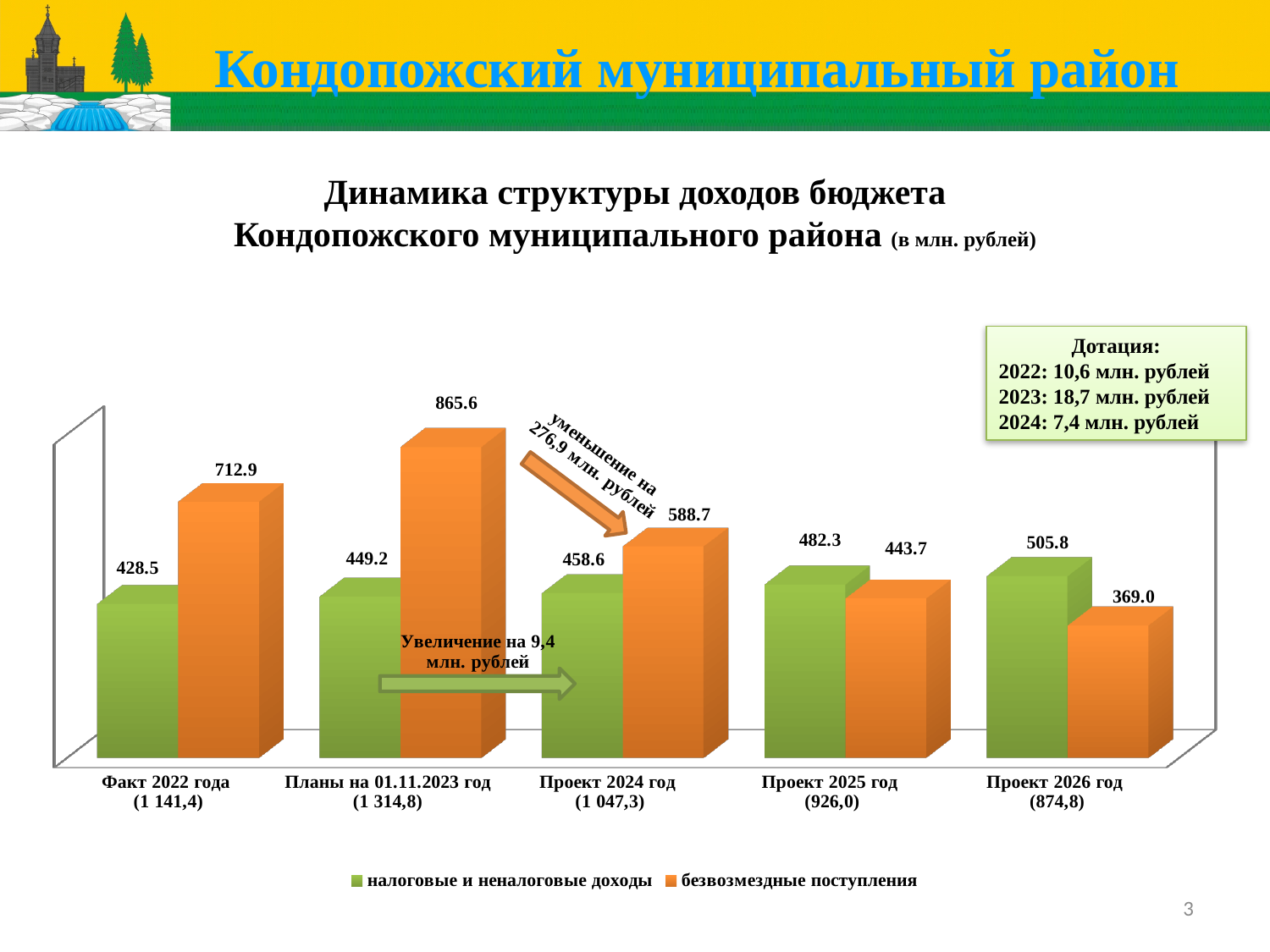
How many categories are shown on the x axis? 5 What is the value of безвозмездные поступления for Проект 2026 год? 369.0 Which category has the highest value for безвозмездные поступления? Планы на 01.11.2023 год What is the value of безвозмездные поступления for Планы на 01.11.2023 год? 865.6 What kind of chart is shown on the slide? bar chart How many series does the legend list? 2 What colour represents безвозмездные поступления in the chart? orange For Проект 2025 год, which is larger: налоговые и неналоговые доходы or безвозмездные поступления? налоговые и неналоговые доходы What is the value of налоговые и неналоговые доходы for Факт 2022 года? 428.5 What is the difference between безвозмездные поступления for Планы на 01.11.2023 год and Проект 2024 год? 276.9 Which category has the lowest value for налоговые и неналоговые доходы? Факт 2022 года Do the values for налоговые и неналоговые доходы rise or fall from Факт 2022 года to Проект 2026 год? rise